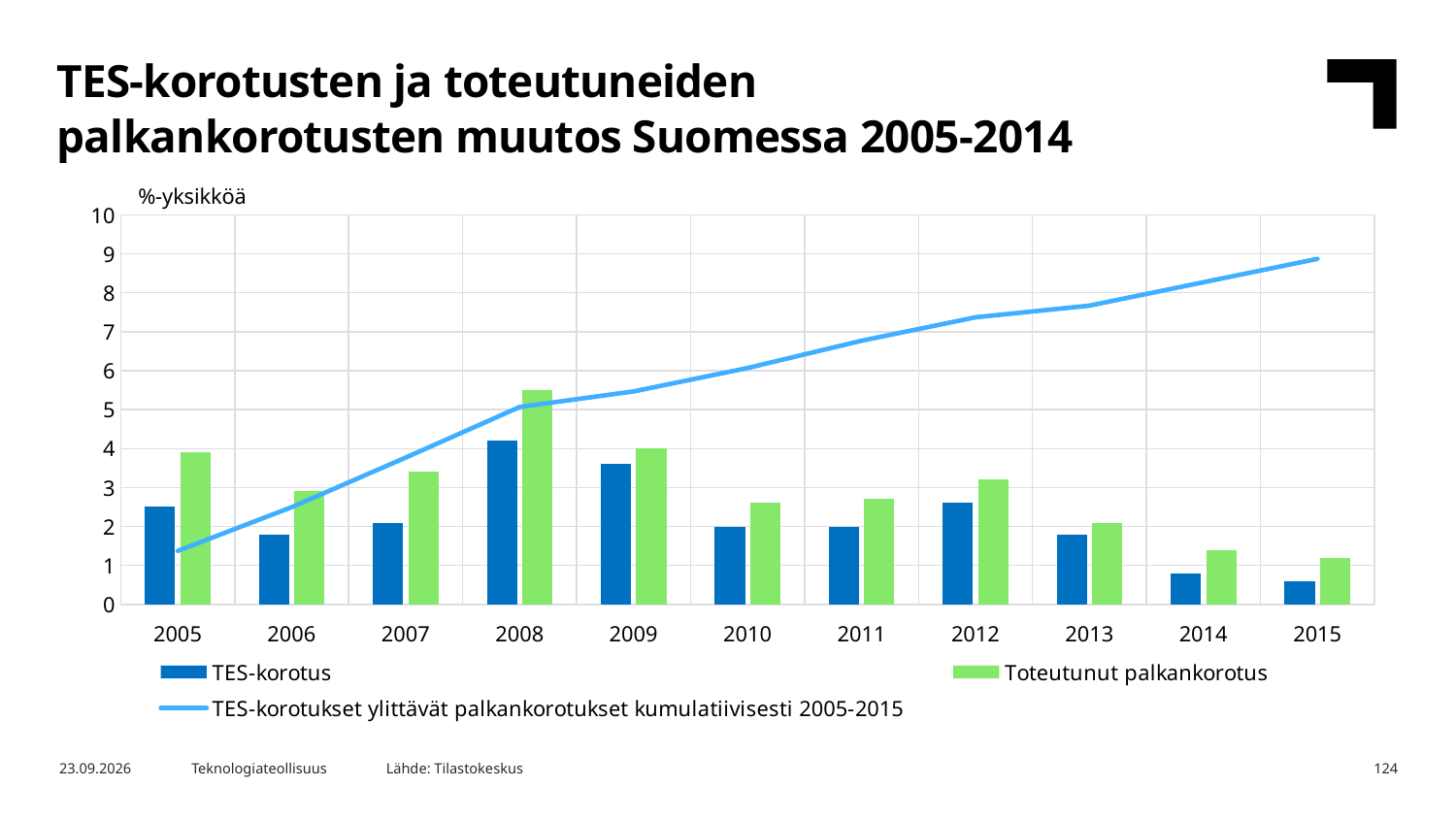
Which is larger in 2008, the TES-korotus bar or the Toteutunut palkankorotus bar? Toteutunut palkankorotus In which year is the Toteutunut palkankorotus bar highest? 2008 Is the TES-korotus value for 2014 greater or less than 1? less How many years are shown on the x axis? 11 Does the line 'TES-korotukset ylittävät palkankorotukset kumulatiivisesti 2005-2015' rise or fall from 2005 to 2015? It rises Is the 2015 value of the line 'TES-korotukset ylittävät palkankorotukset kumulatiivisesti 2005-2015' greater or less than 8? greater In which year is the TES-korotus bar highest? 2008 In which year is the Toteutunut palkankorotus bar lowest? 2015 Is the Toteutunut palkankorotus value for 2008 greater or less than 5? greater What kind of chart is shown on the slide? A combined bar and line chart How many series does the legend list? 3